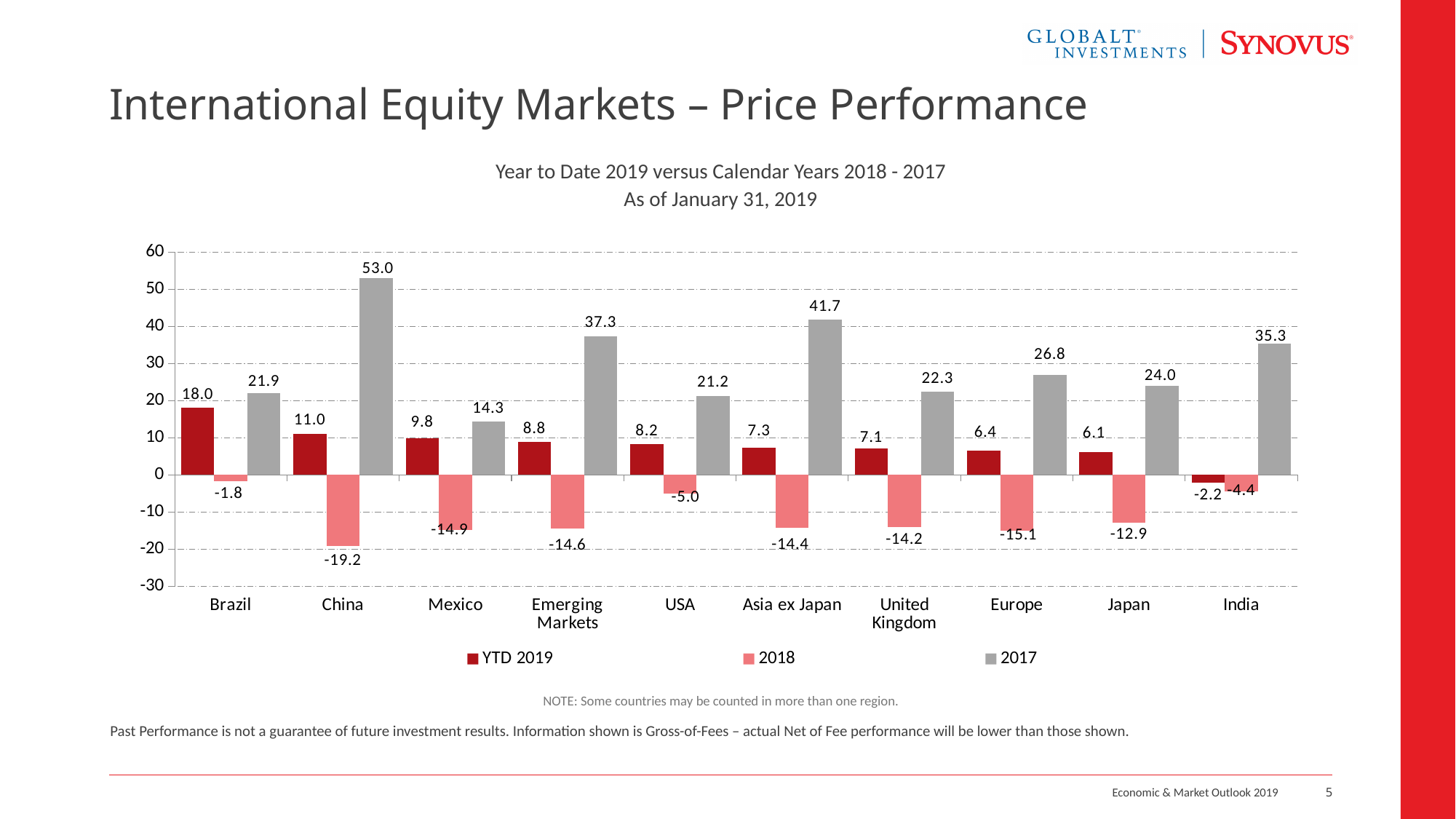
What is the subtitle shown above the chart? Year to Date 2019 versus Calendar Years 2018 - 2017 As of January 31, 2019 What kind of chart is shown on the slide? Bar chart Which is larger, the 2017 value for Europe or the 2017 value for Japan? Europe Which category has the lowest YTD 2019 value? India How many series does the legend list? 3 What is the difference between the 2017 values for China and Mexico? 38.7 Which category has the lowest 2018 value? China How many categories are shown on the x axis? 10 What is the 2017 value for Asia ex Japan? 41.7 What is the 2018 value for China? -19.2 Which category has the highest 2017 value? China What is the YTD 2019 value for Brazil? 18.0